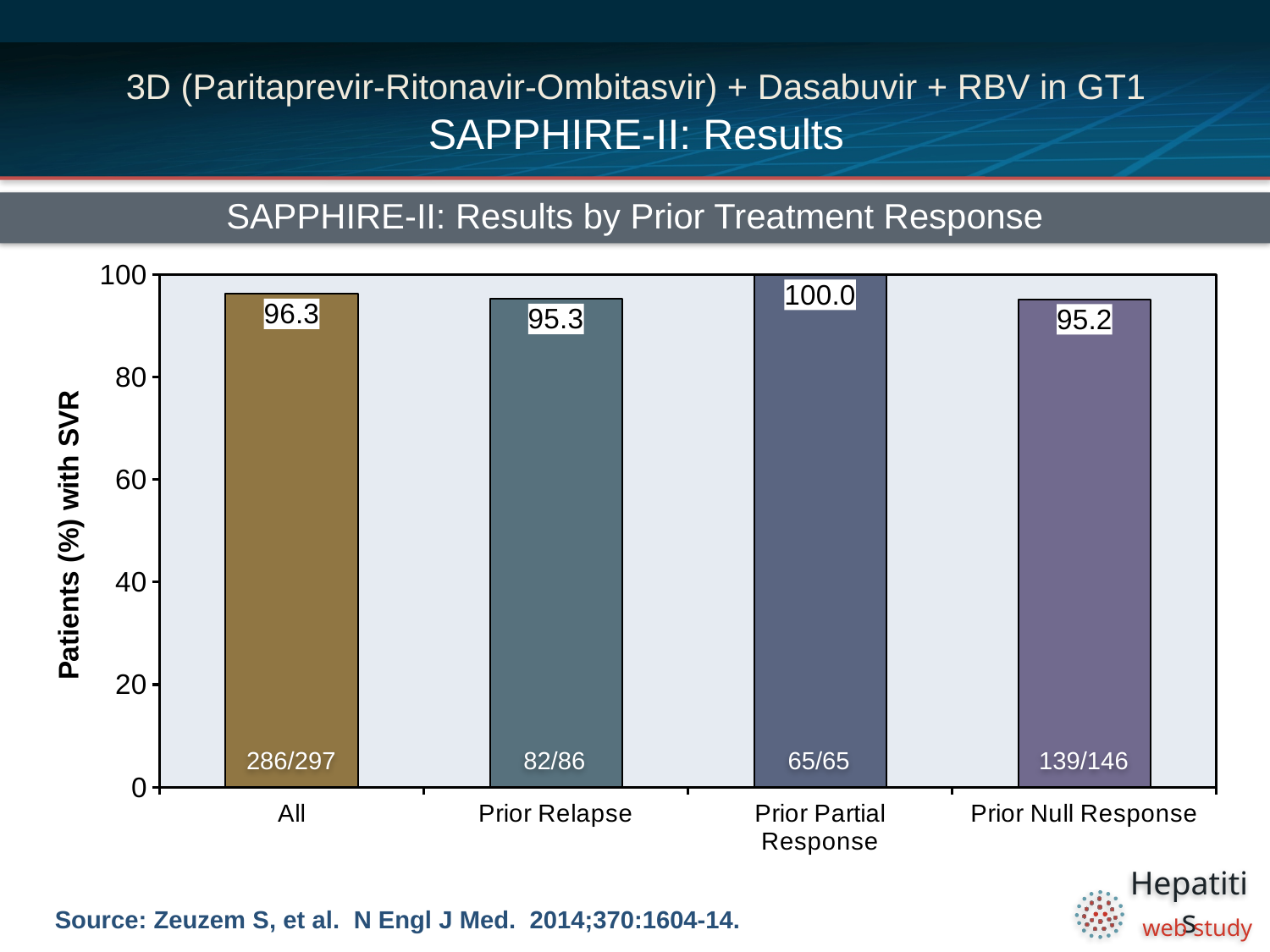
What kind of chart is shown on the slide? Bar chart What is the label of the y axis? Patients (%) with SVR Which has a higher SVR rate, All or Prior Relapse? All What is the SVR rate for the Prior Null Response group? 95.2 What is the difference in SVR rate between Prior Partial Response and Prior Null Response? 4.8 What fraction of patients is shown inside the Prior Partial Response bar? 65/65 What is the SVR rate for the Prior Relapse group? 95.3 Which category has the highest SVR rate? Prior Partial Response What fraction of patients is shown inside the All bar? 286/297 What is the SVR rate for the All group? 96.3 How many categories are shown on the x axis? 4 Which category has the lowest SVR rate? Prior Null Response